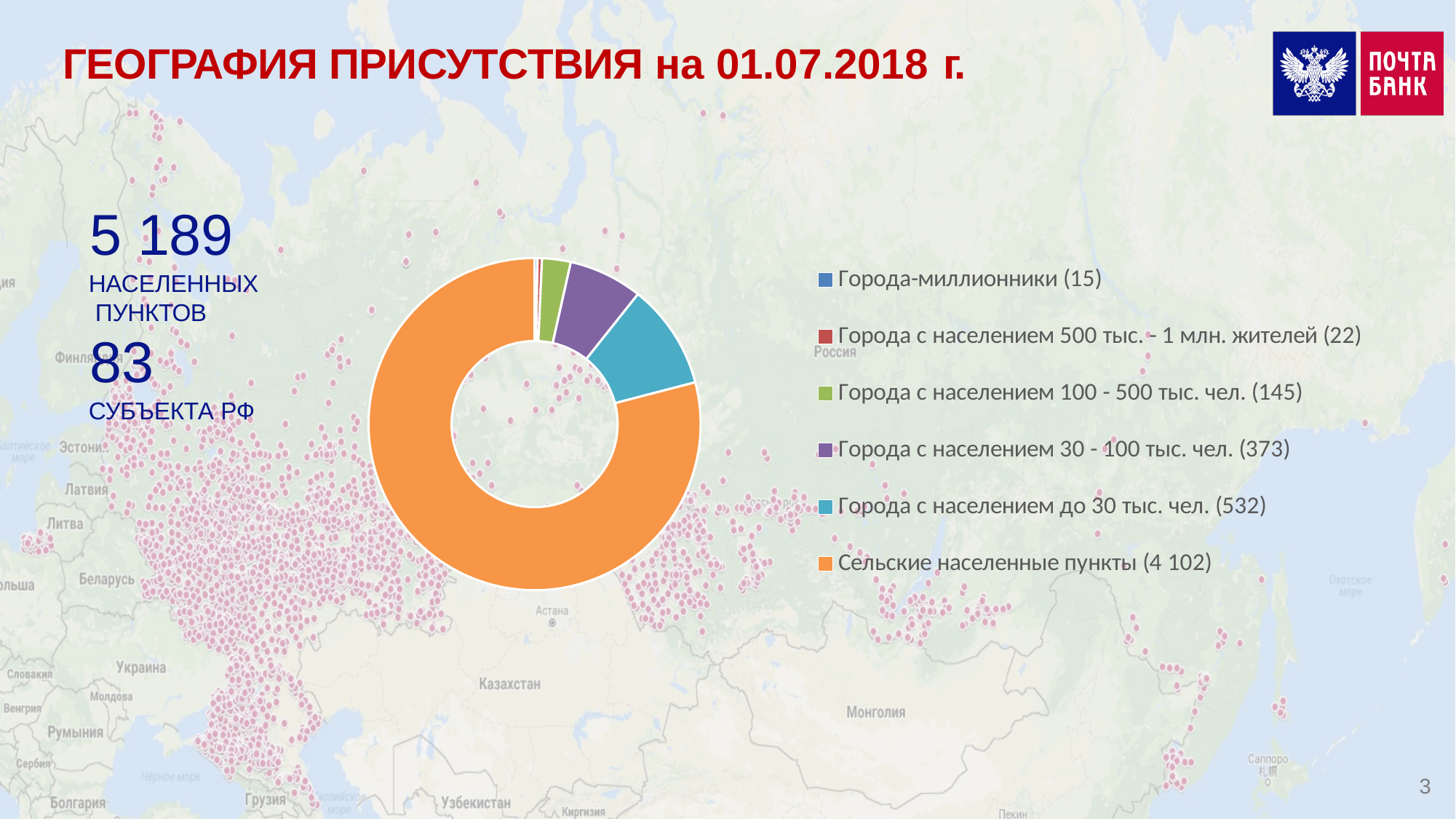
What is the value for Города с населением 30 - 100 тыс. чел.? 373 What is the total of all categories in the donut chart? 5 189 What colour is the segment for Сельские населенные пункты? Orange Which category has the largest value in the donut chart? Сельские населенные пункты What is the value for Города с населением до 30 тыс. чел.? 532 What is the value for Сельские населенные пункты? 4 102 How many categories does the donut chart's legend list? 6 What type of chart is shown on the slide? Donut (pie) chart Which is larger: the value for Города с населением 100 - 500 тыс. чел. or Города с населением 500 тыс. - 1 млн. жителей? Города с населением 100 - 500 тыс. чел. Which category has the smallest value in the donut chart? Города-миллионники What is the value for Города-миллионники? 15 What is the difference between the values for Города с населением до 30 тыс. чел. and Города с населением 30 - 100 тыс. чел.? 159